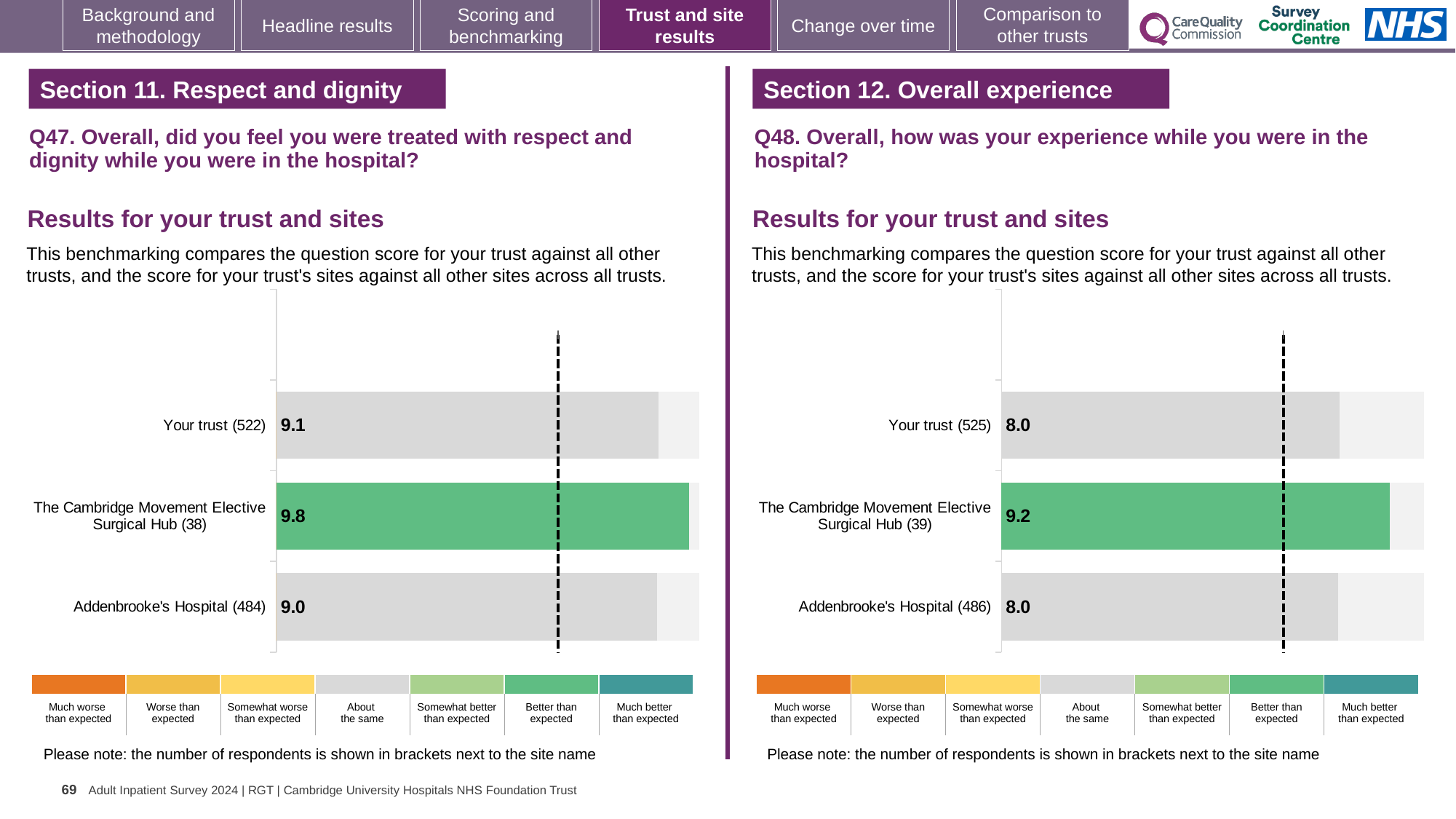
In the Q47 chart on the left, what is the score for The Cambridge Movement Elective Surgical Hub (38)? 9.8 In the Q48 chart on the right, what is the score for The Cambridge Movement Elective Surgical Hub (39)? 9.2 In the Q47 chart on the left, which benchmark category does the green colour of The Cambridge Movement Elective Surgical Hub bar represent according to the legend? Better than expected In the Q48 chart on the right, which is larger: the score for Your trust (525) or The Cambridge Movement Elective Surgical Hub (39)? The Cambridge Movement Elective Surgical Hub (39) In the Q48 chart on the right, what is the difference between the score for The Cambridge Movement Elective Surgical Hub (39) and Your trust (525)? 1.2 In the Q47 chart on the left, which site or trust has the lowest score? Addenbrooke's Hospital (484) In the Q47 chart on the left, what is the score for Your trust (522)? 9.1 In the Q48 chart on the right, which site or trust has the highest score? The Cambridge Movement Elective Surgical Hub (39) What kind of chart is the Q48 chart on the right? Bar chart In the Q48 chart on the right, what is the score for Addenbrooke's Hospital (486)? 8.0 How many bars are plotted in the Q47 chart on the left? 3 In the Q47 chart on the left, what is the difference between the score for The Cambridge Movement Elective Surgical Hub (38) and Addenbrooke's Hospital (484)? 0.8